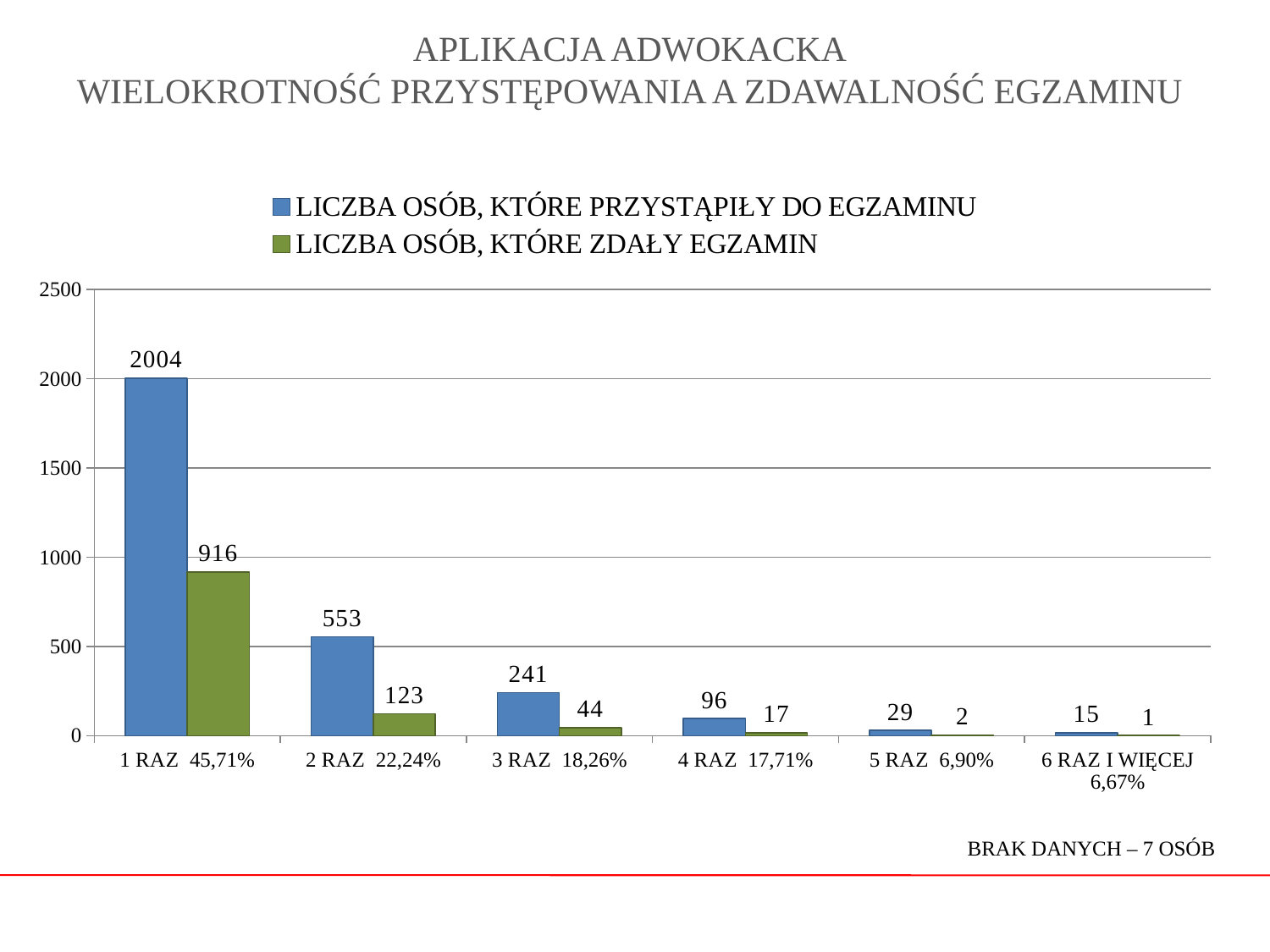
How many people passed the exam (LICZBA OSÓB, KTÓRE ZDAŁY EGZAMIN) in the 2 RAZ category? 123 How many people took the exam for the first time (1 RAZ) according to the LICZBA OSÓB, KTÓRE PRZYSTĄPIŁY DO EGZAMINU series? 2004 What is the difference between the number of people who took the exam and the number who passed in the 3 RAZ category? 197 What is the value for LICZBA OSÓB, KTÓRE ZDAŁY EGZAMIN in the 6 RAZ I WIĘCEJ category? 1 Which category has the lowest value for LICZBA OSÓB, KTÓRE ZDAŁY EGZAMIN? 6 RAZ I WIĘCEJ Which is larger: the number of people who passed in the 1 RAZ category or the number who took the exam in the 2 RAZ category? 1 RAZ passed (916) Which category has the highest value for LICZBA OSÓB, KTÓRE PRZYSTĄPIŁY DO EGZAMINU? 1 RAZ What kind of chart is shown on the slide? bar chart How many series does the legend list? 2 How many categories are shown on the x axis? 6 Is the value for LICZBA OSÓB, KTÓRE PRZYSTĄPIŁY DO EGZAMINU in the 2 RAZ category greater or less than 500? greater Do the values for LICZBA OSÓB, KTÓRE PRZYSTĄPIŁY DO EGZAMINU rise or fall from 1 RAZ to 6 RAZ I WIĘCEJ? fall